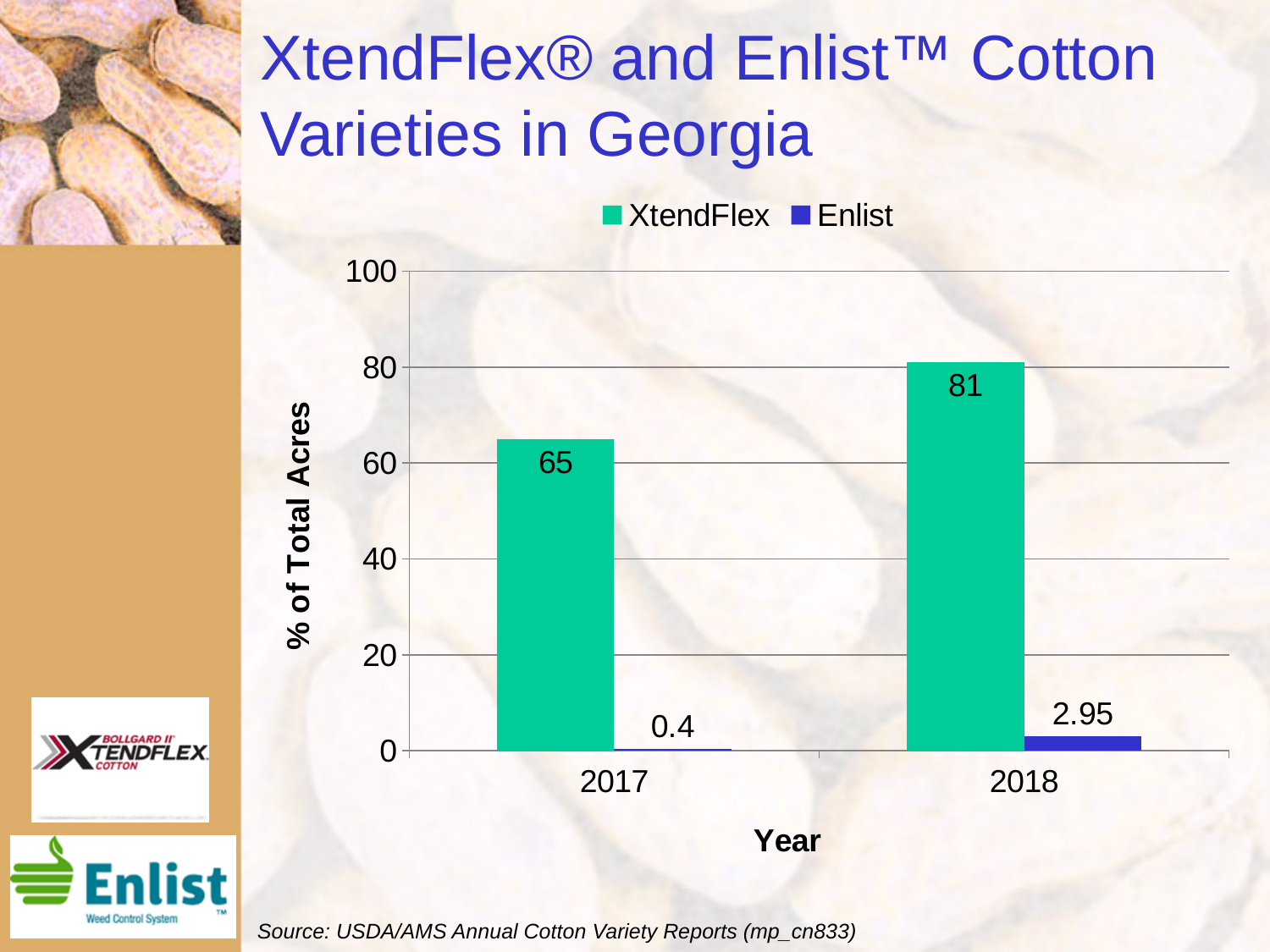
What kind of chart is shown on the slide? bar chart Which is larger: the Enlist value in 2018 or the Enlist value in 2017? 2018 What is the value for Enlist in 2017? 0.4 How many years are shown on the x axis? 2 How many series does the legend list? 2 Which series has the lowest value in 2017? Enlist What is the value for Enlist in 2018? 2.95 What is the value for XtendFlex in 2017? 65 What is the difference between the XtendFlex values for 2018 and 2017? 16 In which year is the XtendFlex value highest? 2018 Is the value for XtendFlex in 2018 greater or less than 80? greater What is the value for XtendFlex in 2018? 81